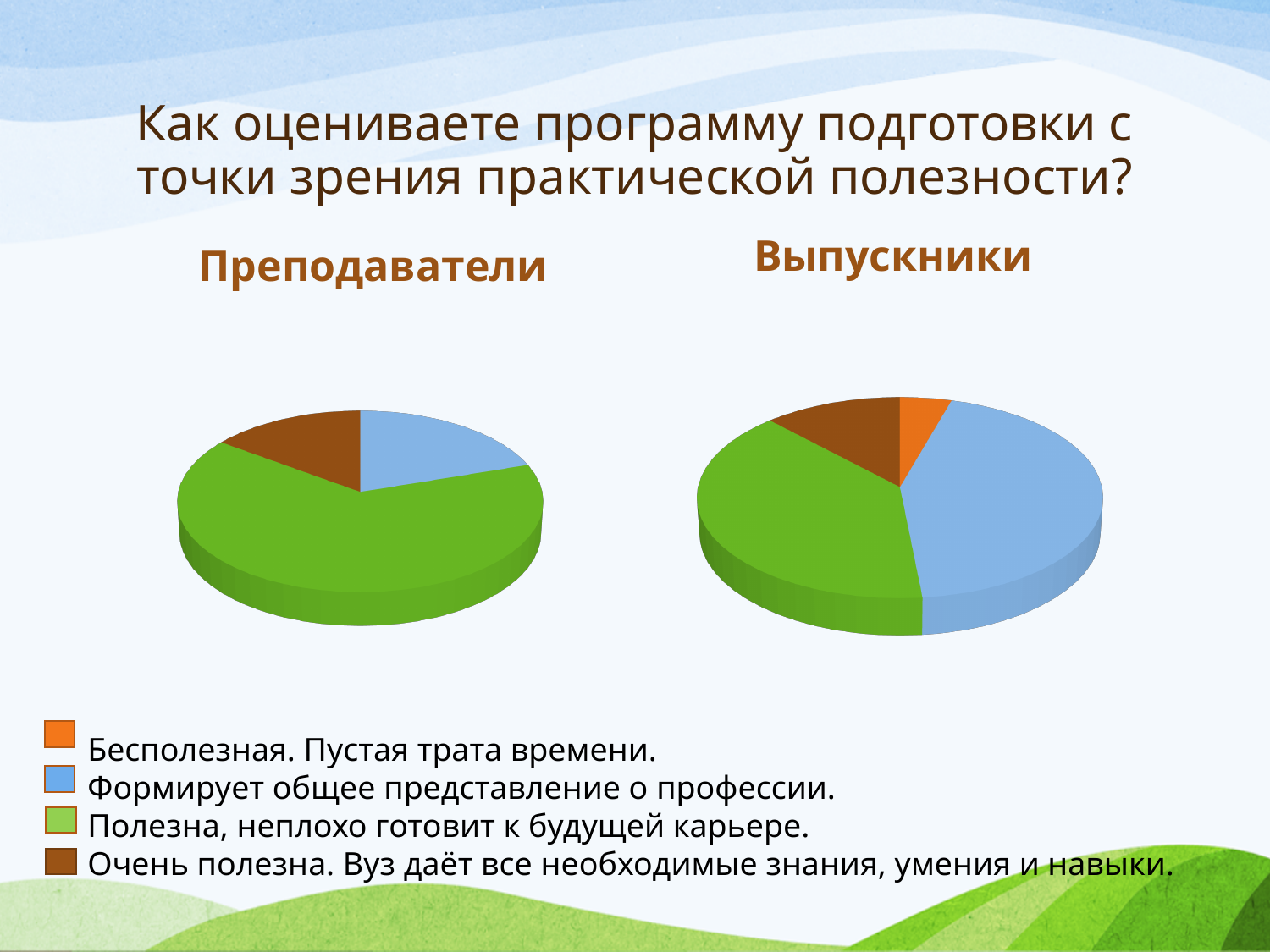
In the "Выпускники" pie chart, which slice is larger: "Формирует общее представление о профессии." or "Очень полезна. Вуз даёт все необходимые знания, умения и навыки."? Формирует общее представление о профессии. How many slices are visible in the "Преподаватели" pie chart? 3 In the "Преподаватели" pie chart, which slice is larger: "Полезна, неплохо готовит к будущей карьере." or "Формирует общее представление о профессии."? Полезна, неплохо готовит к будущей карьере. In the "Преподаватели" pie chart, which category has the largest slice? Полезна, неплохо готовит к будущей карьере. In the "Преподаватели" pie chart, which visible category has the smallest slice? Очень полезна. Вуз даёт все необходимые знания, умения и навыки. What kind of chart is used for the "Выпускники" data? Pie chart In the "Выпускники" pie chart, which slice is larger: "Бесполезная. Пустая трата времени." or "Очень полезна. Вуз даёт все необходимые знания, умения и навыки."? Очень полезна. Вуз даёт все необходимые знания, умения и навыки. How many categories does the legend list? 4 In the "Выпускники" pie chart, which category has the smallest slice? Бесполезная. Пустая трата времени. How many slices are visible in the "Выпускники" pie chart? 4 Which colour represents "Бесполезная. Пустая трата времени." in the legend? Orange What kind of chart is used for the "Преподаватели" data? Pie chart